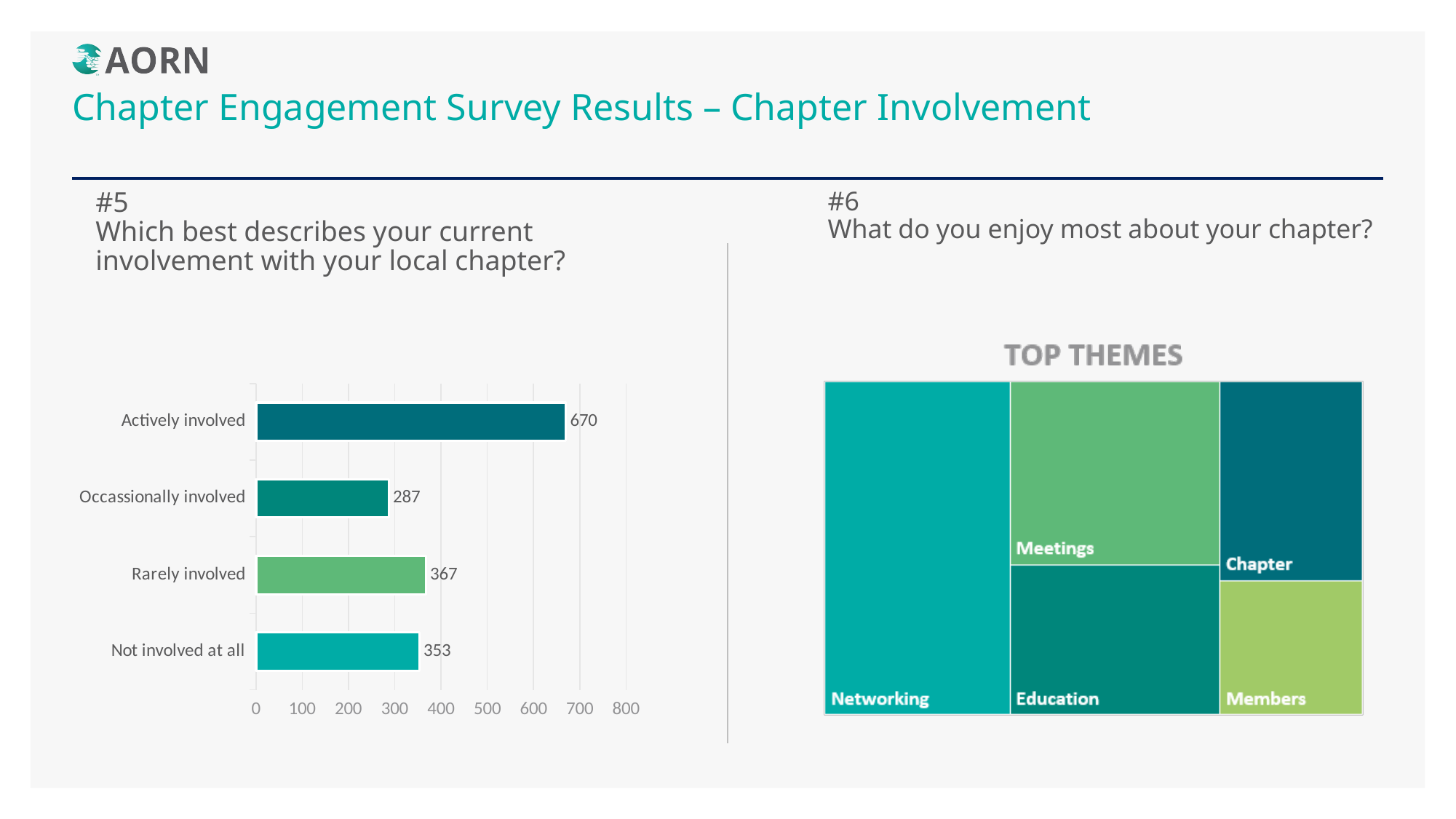
In the TOP THEMES chart on the right, which theme occupies the largest area? Networking In the #5 chart on the left, what is the value for Not involved at all? 353 What kind of chart is the #5 chart on the left? Bar chart In the #5 chart on the left, which category has the lowest value? Occassionally involved In the TOP THEMES chart on the right, how many themes are shown? 5 In the #5 chart on the left, how many categories are shown? 4 In the #5 chart on the left, what is the value for Occassionally involved? 287 In the #5 chart on the left, what is the value for Rarely involved? 367 In the #5 chart on the left, what is the difference between Actively involved and Occassionally involved? 383 In the #5 chart on the left, which category has the highest value? Actively involved In the #5 chart on the left, what is the value for Actively involved? 670 In the #5 chart on the left, which is larger: Rarely involved or Not involved at all? Rarely involved